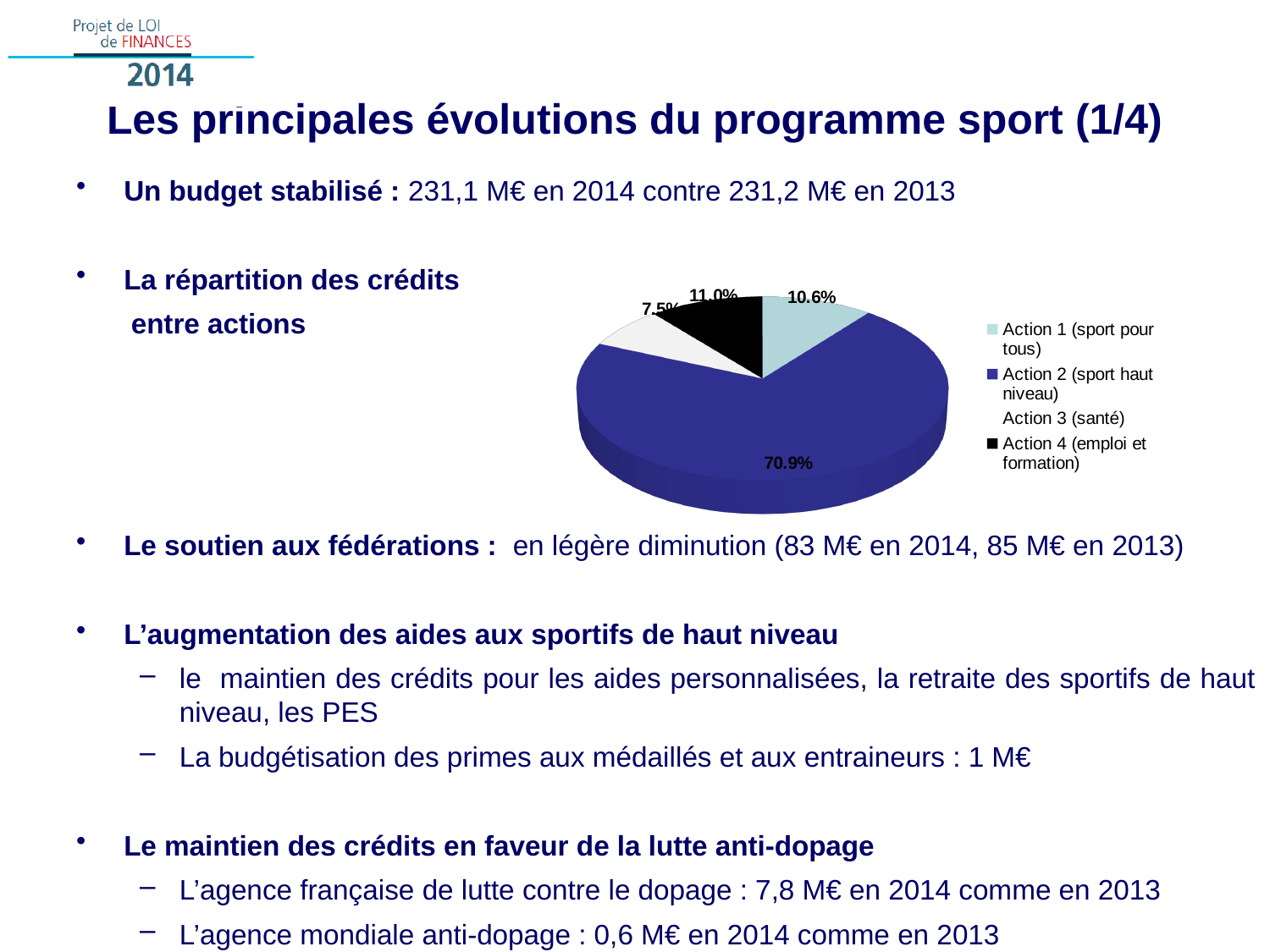
Which legend entry is shown in black in the pie chart? Action 4 (emploi et formation) Which has a larger share of the pie, Action 4 (emploi et formation) or Action 3 (santé)? Action 4 (emploi et formation) What is the difference in percentage points between the shares of Action 2 (sport haut niveau) and Action 1 (sport pour tous)? 60.3 Which action has the smallest share of the pie? Action 3 (santé) What share of the pie does Action 2 (sport haut niveau) represent? 70.9% What kind of chart is shown on the slide? pie chart How many slices does the pie chart have? 4 Which action has the largest share of the pie? Action 2 (sport haut niveau) What share of the pie does Action 3 (santé) represent? 7.5% What share of the pie does Action 1 (sport pour tous) represent? 10.6% How many entries does the legend of the pie chart list? 4 What share of the pie does Action 4 (emploi et formation) represent? 11.0%